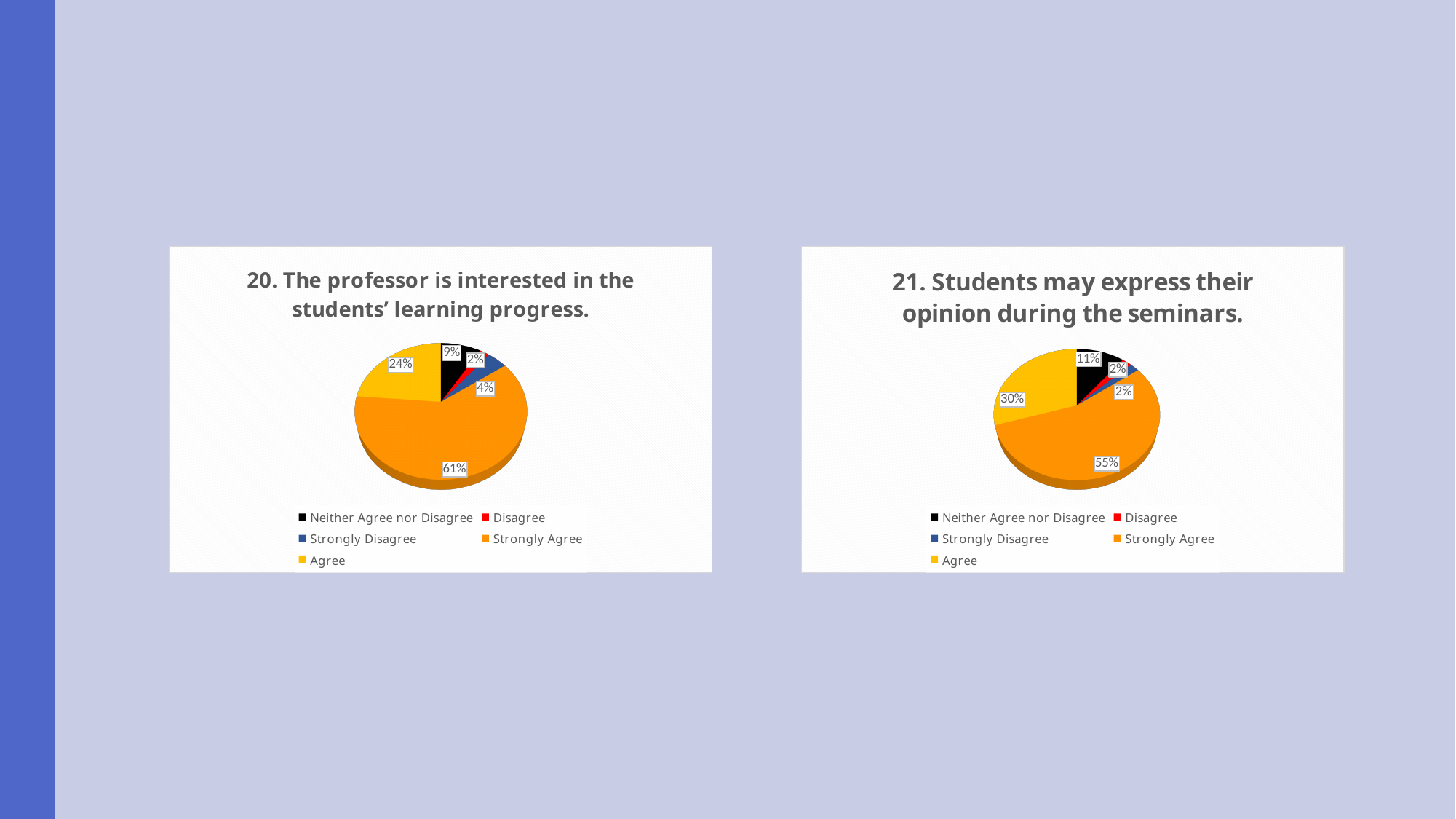
Which chart has the larger Agree share, the left chart (question 20) or the right chart (question 21)? The right chart (question 21) In the chart titled "20. The professor is interested in the students' learning progress.", which response category has the largest share? Strongly Agree In the chart titled "21. Students may express their opinion during the seminars.", what share of responses is Strongly Agree? 55% How many response categories does the legend of the right chart (question 21) list? 5 In the chart titled "20. The professor is interested in the students' learning progress.", what share of responses is Strongly Agree? 61% In the chart titled "21. Students may express their opinion during the seminars.", what share of responses is Agree? 30% What type of chart is used on the left side of the slide for question 20? Pie chart In the chart titled "21. Students may express their opinion during the seminars.", what share of responses is Neither Agree nor Disagree? 11% In the chart titled "20. The professor is interested in the students' learning progress.", what share of responses is Neither Agree nor Disagree? 9% In the chart titled "20. The professor is interested in the students' learning progress.", what share of responses is Agree? 24% In the chart titled "21. Students may express their opinion during the seminars.", which response category has the largest share? Strongly Agree In the chart titled "20. The professor is interested in the students' learning progress.", what is the difference between the Strongly Agree and Agree shares? 37%